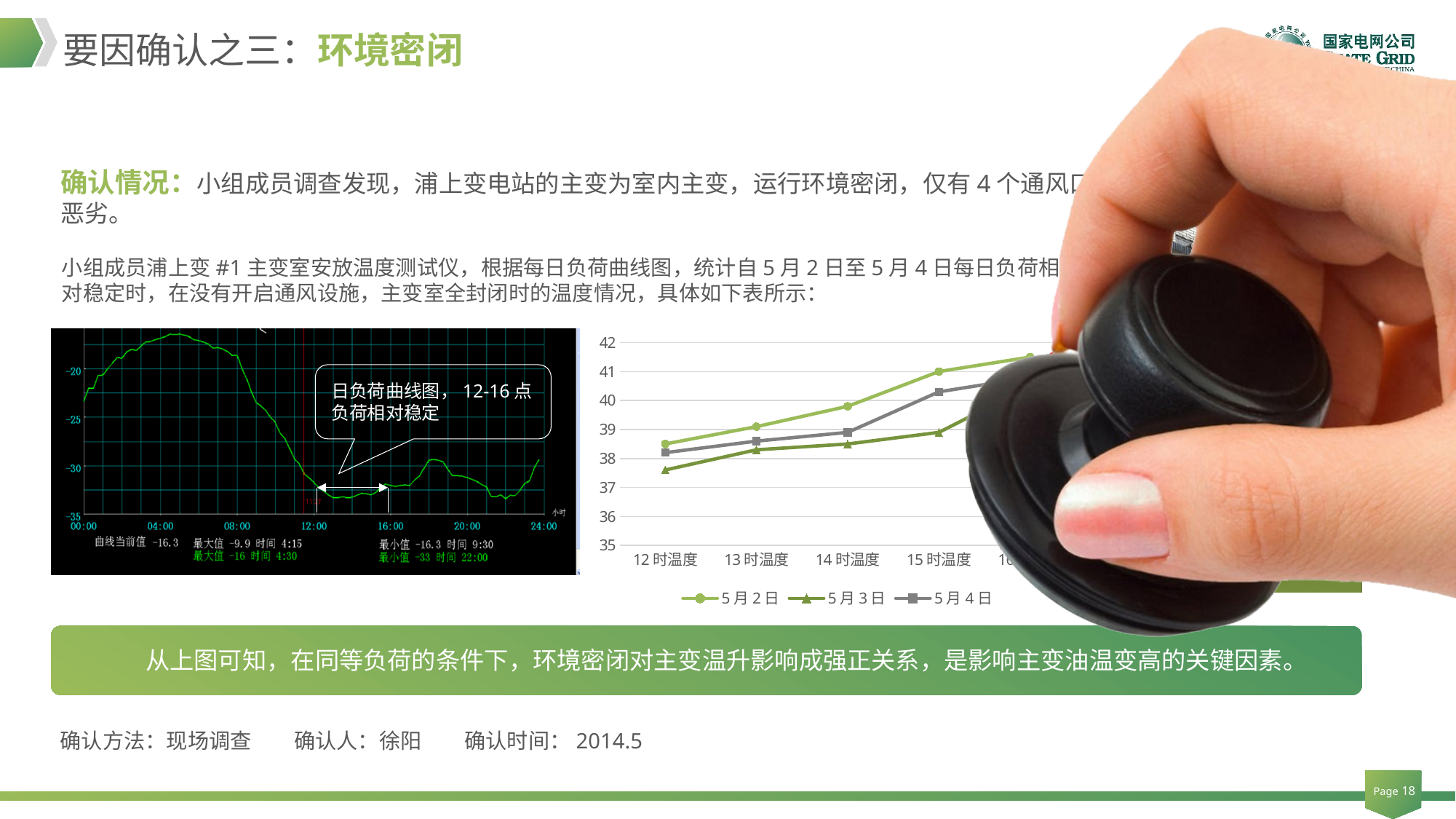
What are the three series named in the legend of the line chart? 5月2日, 5月3日, 5月4日 In the line chart, which series has the higher value at 15时温度, 5月2日 or 5月4日? 5月2日 In the line chart, which series has the lowest value at 12时温度? 5月3日 In the line chart, which series has the higher value at 12时温度, 5月2日 or 5月3日? 5月2日 In the line chart, is the value for 5月4日 at 15时温度 greater or less than 39? greater In the line chart, is the value for 5月3日 at 12时温度 greater or less than 38? less What kind of chart is the chart on the right of the slide? line chart In the line chart, does the 5月2日 series rise or fall from 12时温度 to 15时温度? rise How many series does the legend of the line chart list? 3 In the line chart, is the value for 5月2日 at 15时温度 greater or less than 40? greater